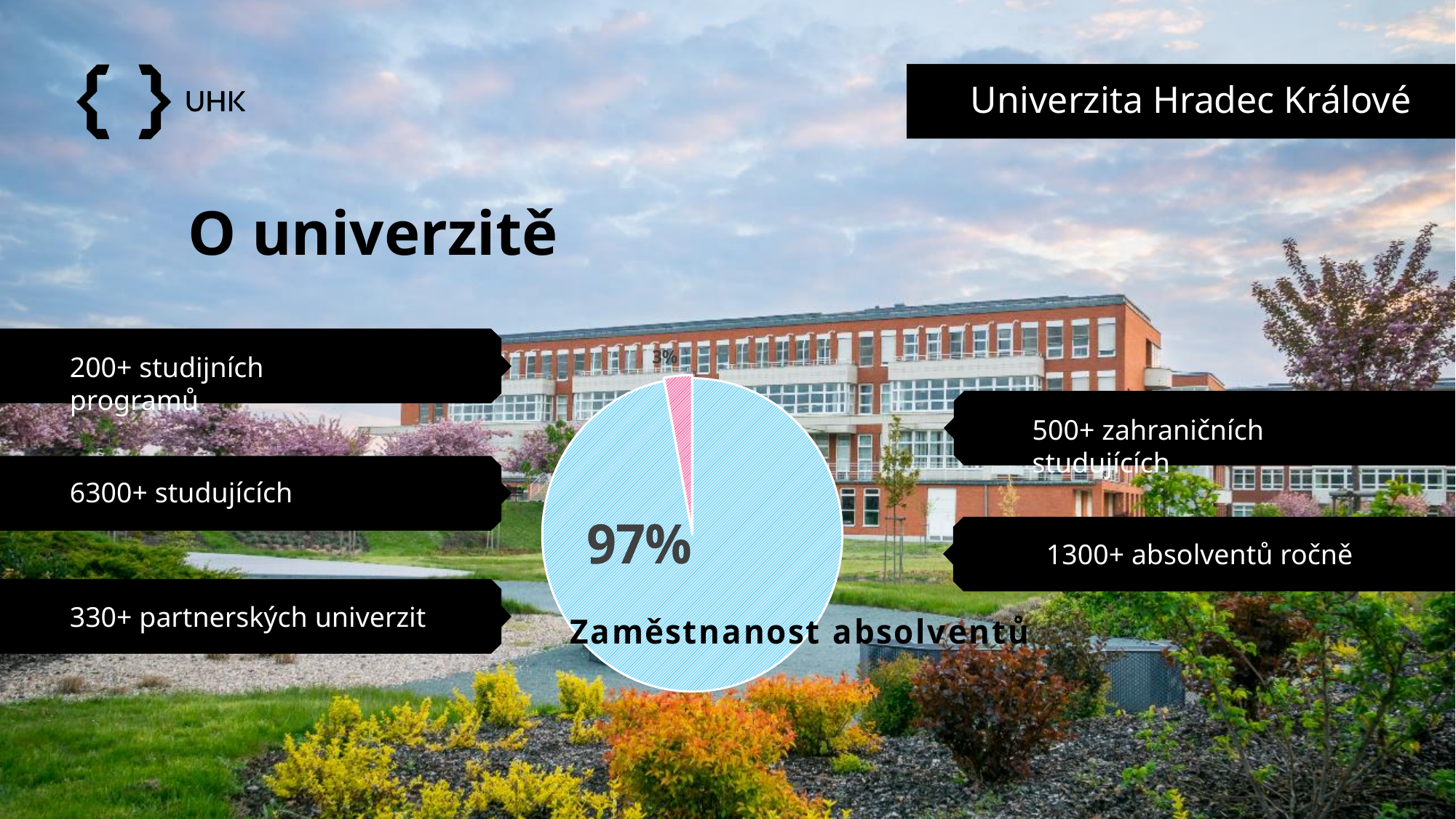
What kind of chart is shown on the slide? pie chart What is the value of the largest slice in the pie chart? 97% Which slice of the pie chart is larger, the blue one or the pink one? the blue one What is the value of the smallest slice in the pie chart? 3% What value is shown for the large blue slice of the pie chart? 97% What colour is the slice labelled 3%? pink How many slices does the pie chart have? 2 What value is shown for the small pink slice of the pie chart? 3% By how many percentage points does the blue slice exceed the pink slice? 94 What is the title of the pie chart? Zaměstnanost absolventů